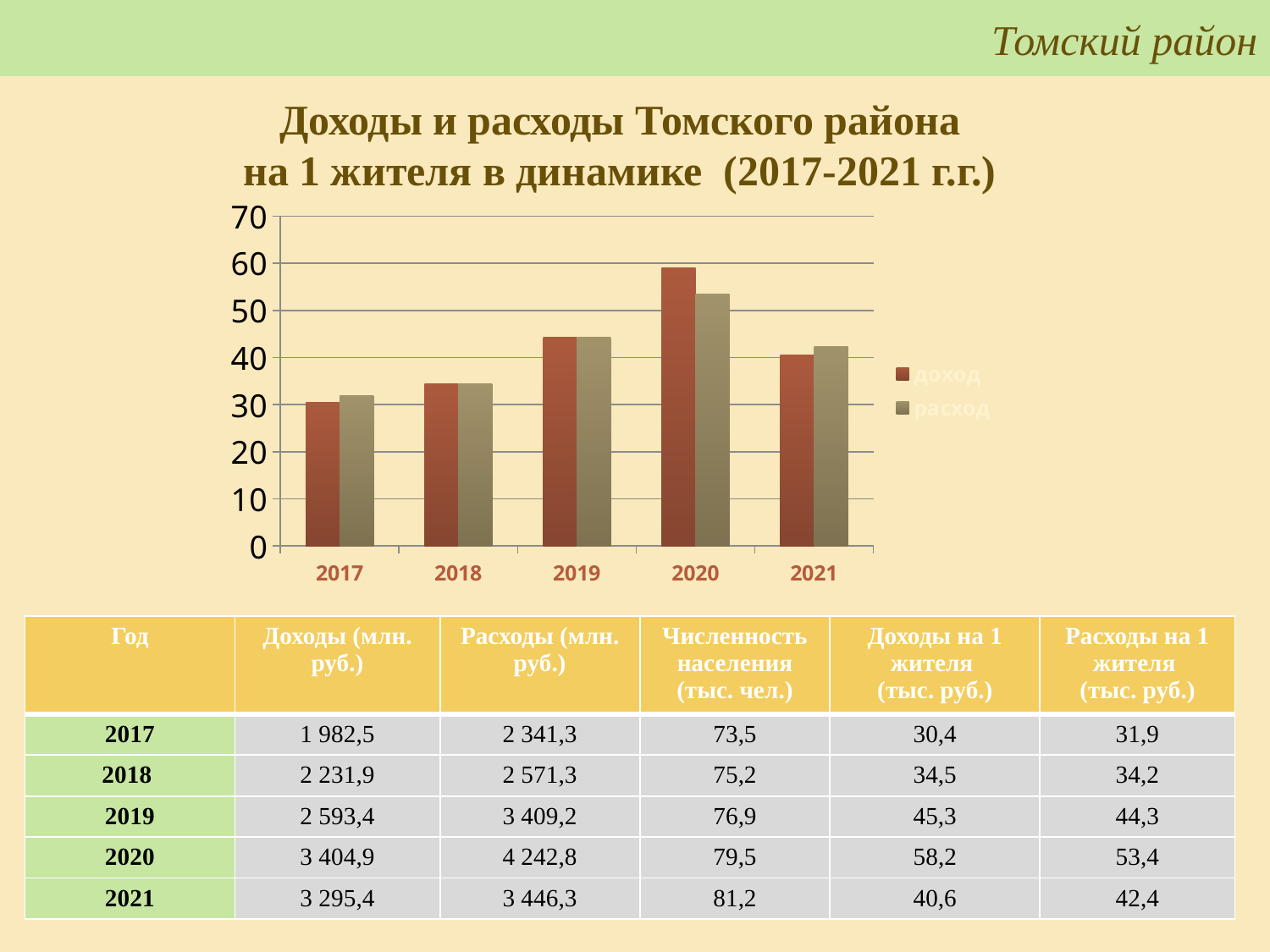
Is the доход value for 2020 greater or less than 50? greater In 2020, which is larger, доход or расход? доход How many series does the chart legend list? 2 Does the доход series rise or fall from 2017 to 2020? rise How many years are shown on the x axis of the chart? 5 What kind of chart is shown on the slide? bar chart What are the two entries in the chart legend? доход, расход What is the доход per resident value for 2019 (тыс. руб.)? 45,3 In which year is the доход bar the lowest? 2017 What is the difference between доход and расход per resident in 2020 (тыс. руб.)? 4,8 Is the расход value for 2017 greater or less than 40? less In which year is the доход bar the highest? 2020